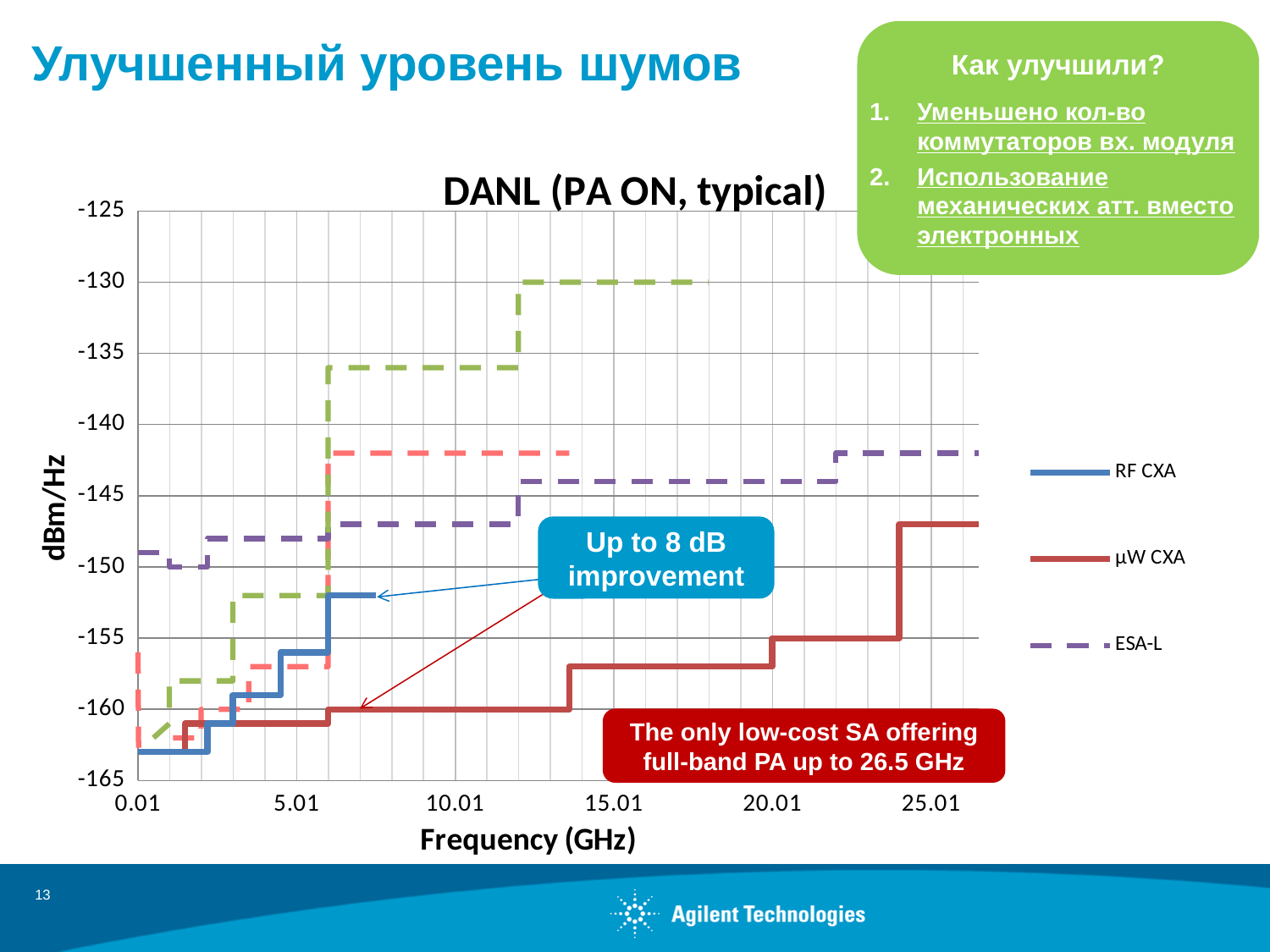
Is the value for ESA-L at 10 GHz greater or less than -150? greater At 20 GHz, which series has the higher value, ESA-L or µW CXA? ESA-L Is the value for µW CXA at 15 GHz greater or less than -150? less What is the label of the vertical axis of the chart? dBm/Hz Is the value for ESA-L at 25 GHz greater or less than -145? greater What is the title of the chart? DANL (PA ON, typical) How many series does the chart's legend list? 3 At 1 GHz, which series has the higher value, RF CXA or ESA-L? ESA-L Do the values for µW CXA rise or fall as frequency increases along the x axis? rise What kind of chart is shown on the slide? line chart